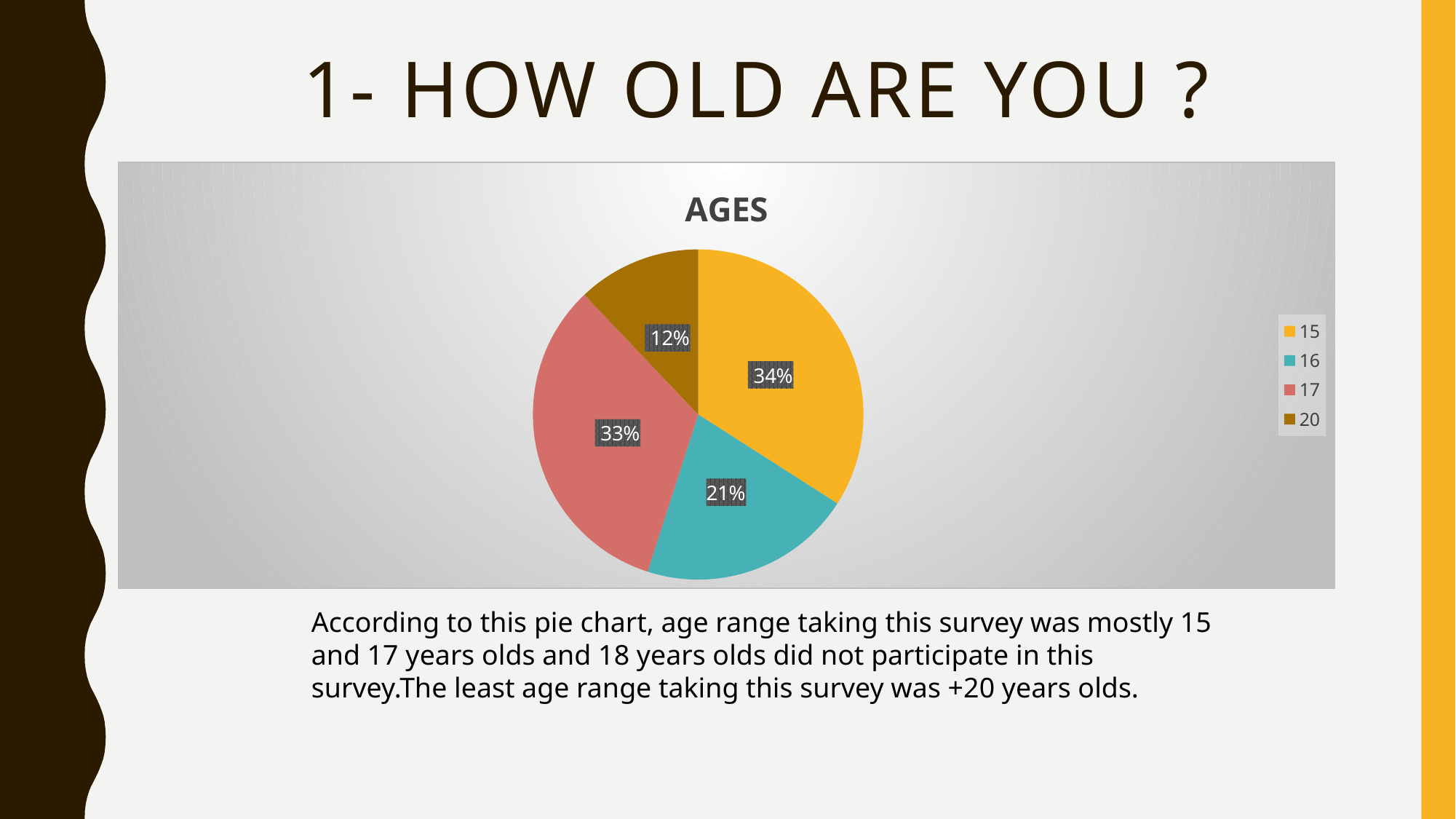
What percentage of the pie is the slice for age 20? 12% Which age has the smallest slice of the pie? 20 What percentage of the pie is the slice for age 15? 34% Which age has the largest slice of the pie? 15 Which slice is larger, age 16 or age 20? 16 What is the difference in percentage points between the slices for age 16 and age 20? 9 What is the title of the chart? AGES What percentage of the pie is the slice for age 17? 33% What percentage of the pie is the slice for age 16? 21% What colour is the slice for age 17? red What kind of chart is shown on the slide? pie chart How many slices does the pie chart have? 4